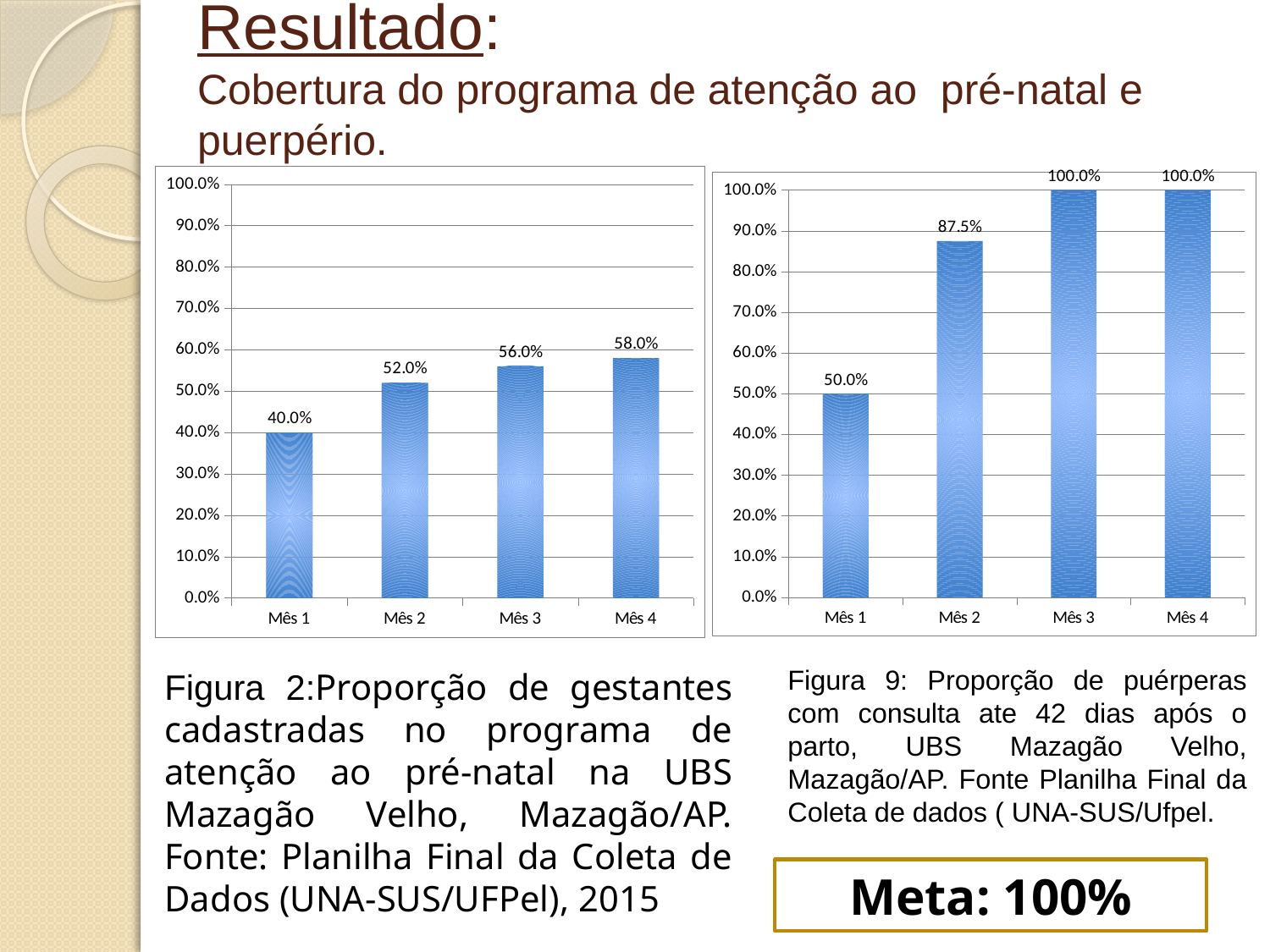
How many months are shown on the x axis of the left chart? 4 In the right chart, what is the value for Mês 1? 50.0% In the left chart, which month has the highest value? Mês 4 In the right chart, which month has the lowest value? Mês 1 In the right chart, is the value for Mês 2 larger than the value for Mês 1? Yes What kind of chart is the right chart? Bar chart In the right chart, what is the value for Mês 2? 87.5% In the left chart, what is the value for Mês 3? 56.0% In the left chart, do the values rise or fall from Mês 1 to Mês 4? Rise In the left chart, what is the difference between the values for Mês 4 and Mês 1? 18.0% In the right chart, what is the difference between the values for Mês 2 and Mês 1? 37.5% In the left chart, what is the value for Mês 1? 40.0%